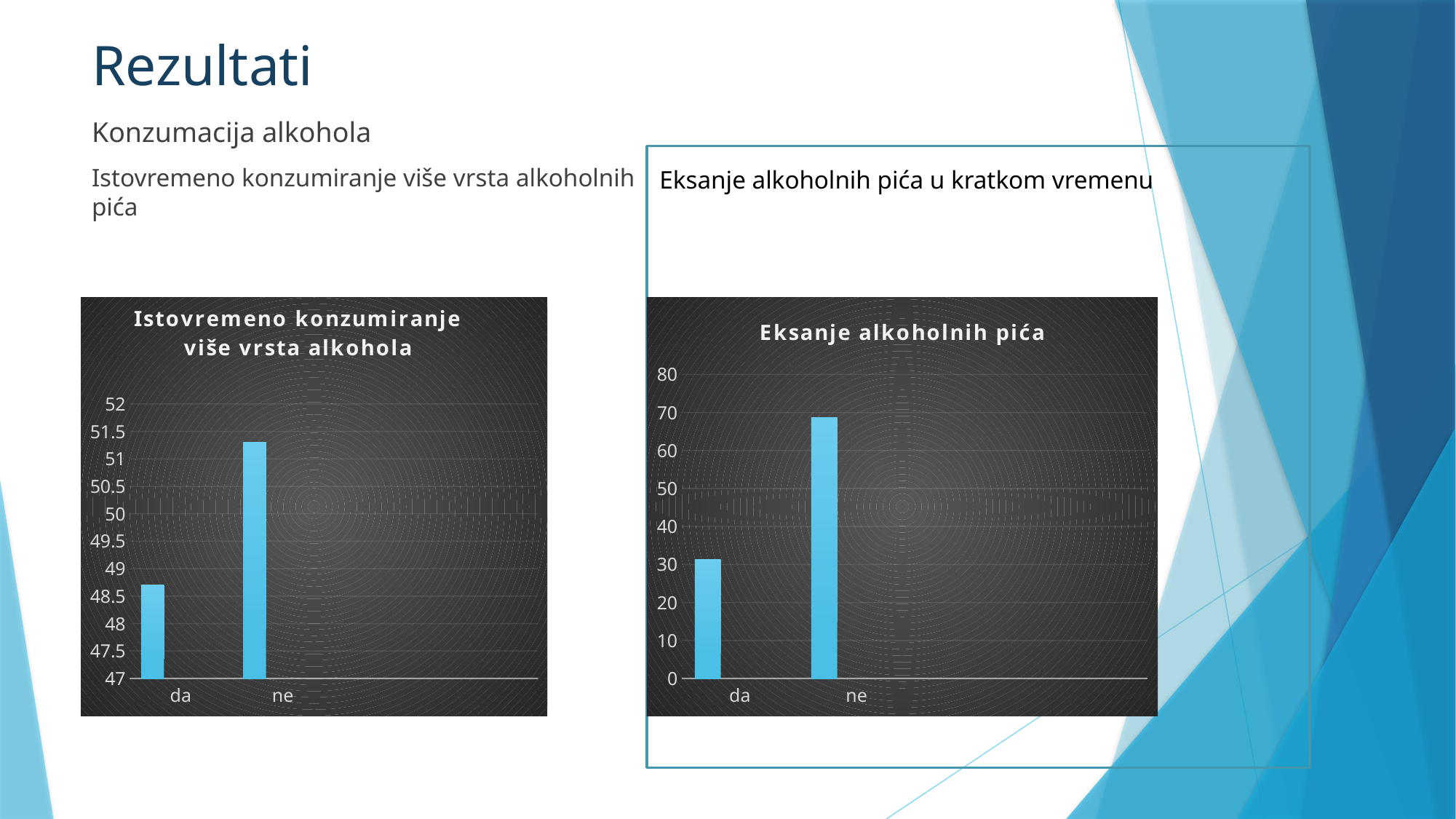
In the left chart "Istovremeno konzumiranje više vrsta alkohola", how many categories are shown on the x axis? 2 In the right chart "Eksanje alkoholnih pića", is the value for "ne" greater or less than 60? greater In the right chart "Eksanje alkoholnih pića", which category has the lowest value? da In the right chart "Eksanje alkoholnih pića", which category has the highest value? ne In the right chart "Eksanje alkoholnih pića", how many bars are plotted? 2 What is the title of the chart on the right side of the slide? Eksanje alkoholnih pića What kind of chart is the right chart titled "Eksanje alkoholnih pića"? bar chart What kind of chart is the left chart titled "Istovremeno konzumiranje više vrsta alkohola"? bar chart In the left chart "Istovremeno konzumiranje više vrsta alkohola", which category has the lowest bar? da In the right chart "Eksanje alkoholnih pića", is the value for "da" greater or less than 40? less In the left chart "Istovremeno konzumiranje više vrsta alkohola", which category has the highest bar? ne In the left chart "Istovremeno konzumiranje više vrsta alkohola", is the value for "da" greater or less than 49? less